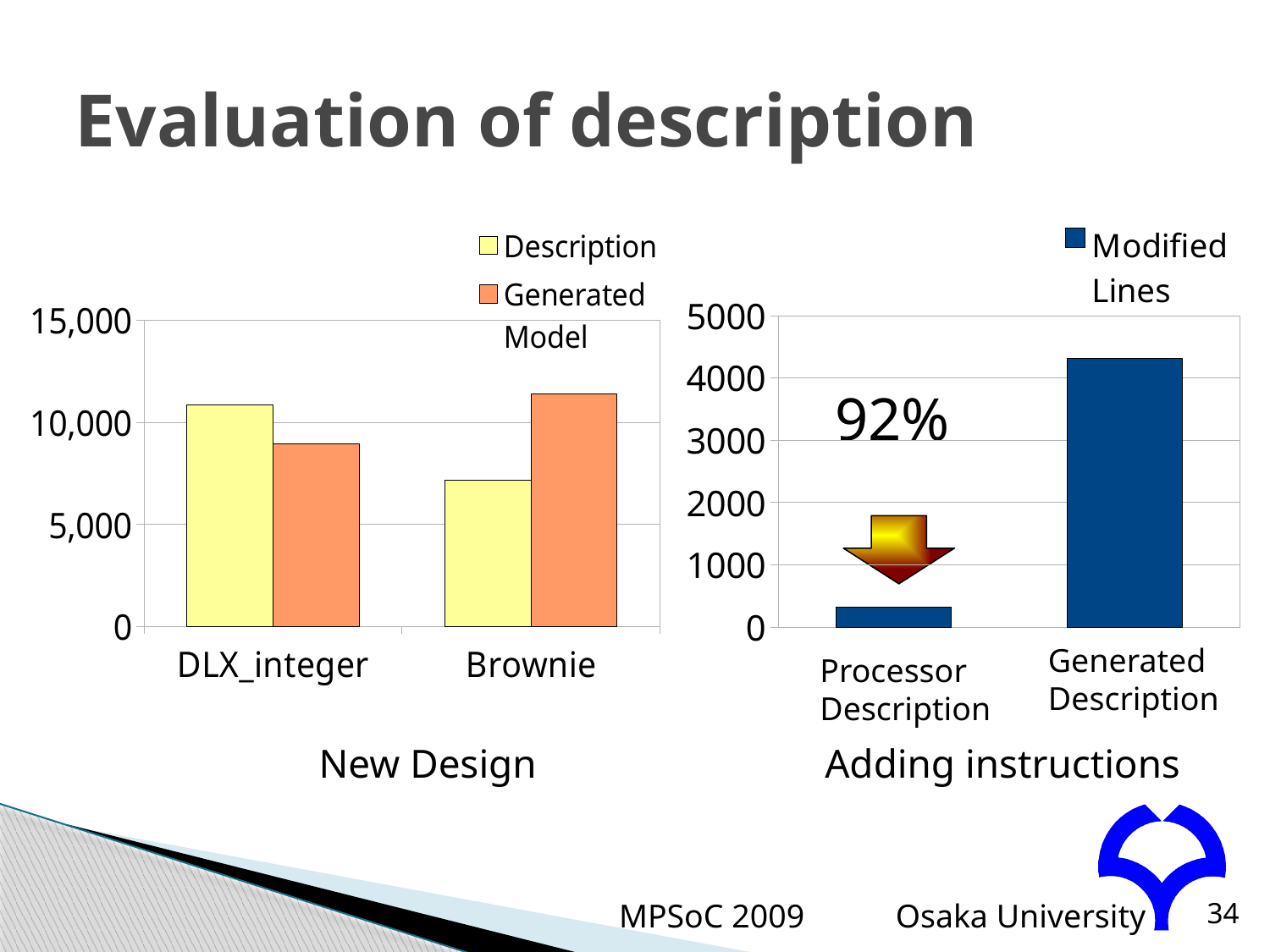
On the right chart (Adding instructions), which category has the highest number of Modified Lines? Generated Description On the left chart (New Design), is the Generated Model value for Brownie greater or less than 10,000? greater On the right chart (Adding instructions), what series name does the legend show? Modified Lines On the left chart (New Design), for DLX_integer, which series has the larger value: Description or Generated Model? Description On the left chart (New Design), what kind of chart is shown? bar chart On the left chart (New Design), how many series does the legend list? 2 On the left chart (New Design), how many categories are shown on the x axis? 2 On the left chart (New Design), is the Description value for Brownie greater or less than 10,000? less On the left chart (New Design), is the Description value for DLX_integer greater or less than 10,000? greater On the left chart (New Design), for Brownie, which series has the larger value: Description or Generated Model? Generated Model